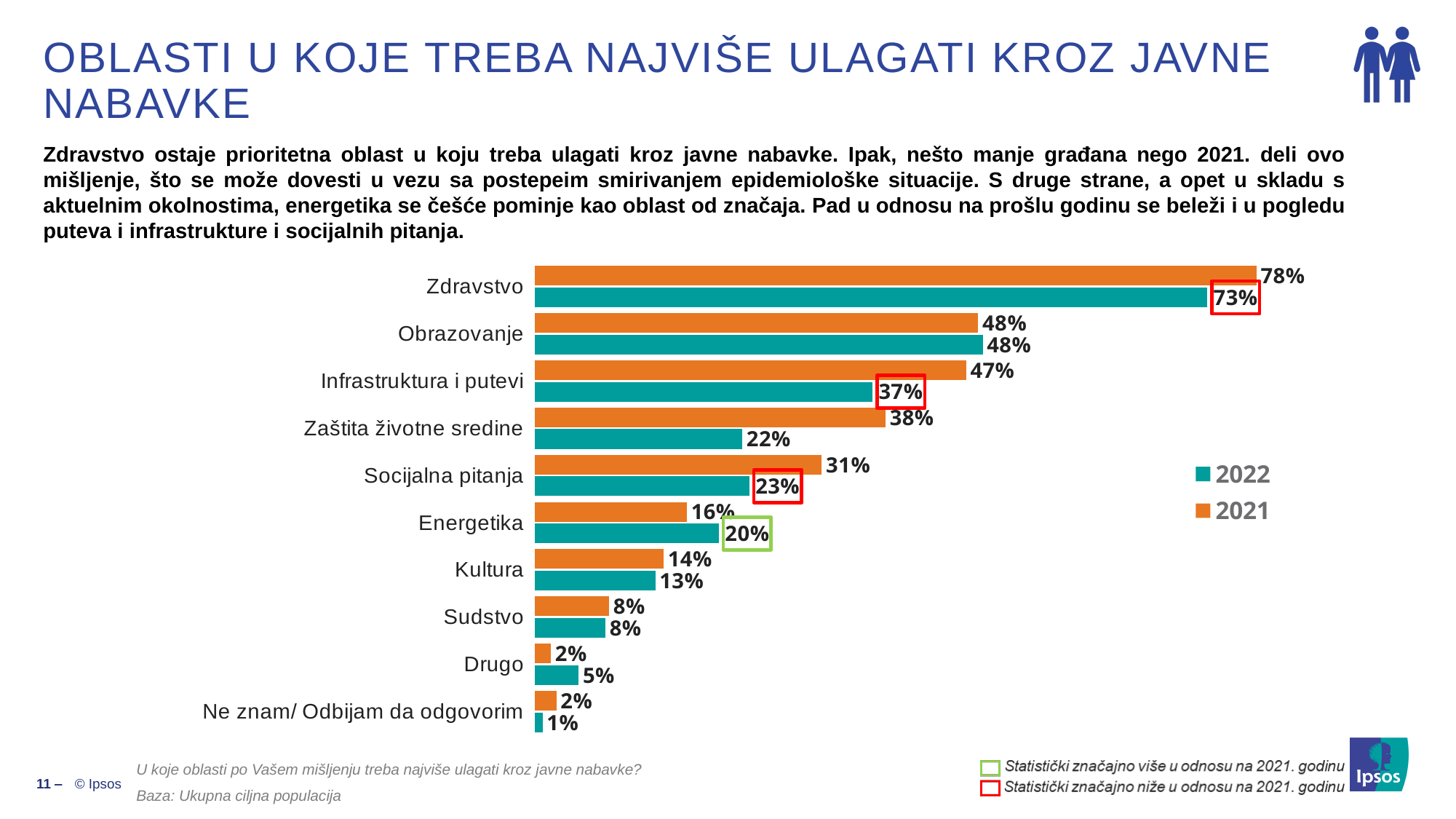
Which is larger for Energetika, the 2022 value or the 2021 value? 2022 How many categories are shown in the chart? 10 Which colour represents the 2021 series in the chart? Orange What kind of chart is shown on the slide? Bar chart Which category has the lowest 2022 value? Ne znam/ Odbijam da odgovorim How many series does the legend list? 2 Which is larger for Socijalna pitanja, the 2021 value or the 2022 value? 2021 What is the difference between the 2021 and 2022 values for Infrastruktura i putevi? 10% What is the 2022 value for Zdravstvo? 73% What is the 2021 value for Zaštita životne sredine? 38% Which category has the highest 2022 value? Zdravstvo What is the 2022 value for Energetika? 20%